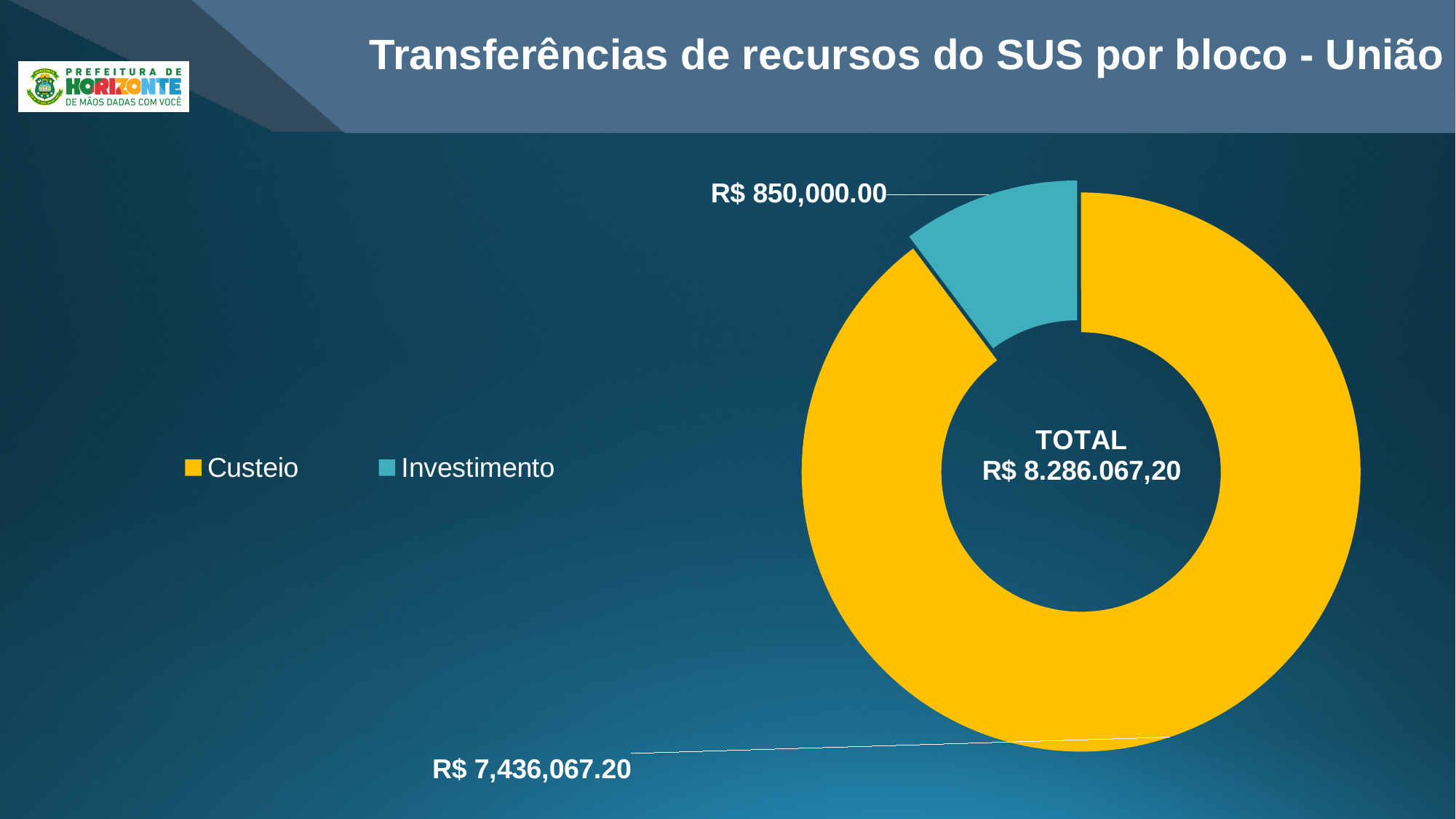
What is the value for Custeio? R$ 7,436,067.20 Which is larger, Custeio or Investimento? Custeio What total is printed in the centre of the chart? R$ 8.286.067,20 What kind of chart is shown on the slide? Doughnut (pie) chart What is the title of the chart? Transferências de recursos do SUS por bloco - União Which category has the smallest value? Investimento Which category has the largest value? Custeio What is the value for Investimento? R$ 850,000.00 How many entries does the legend list? 2 How many categories does the chart show? 2 What is the difference between the Custeio and Investimento values? R$ 6,586,067.20